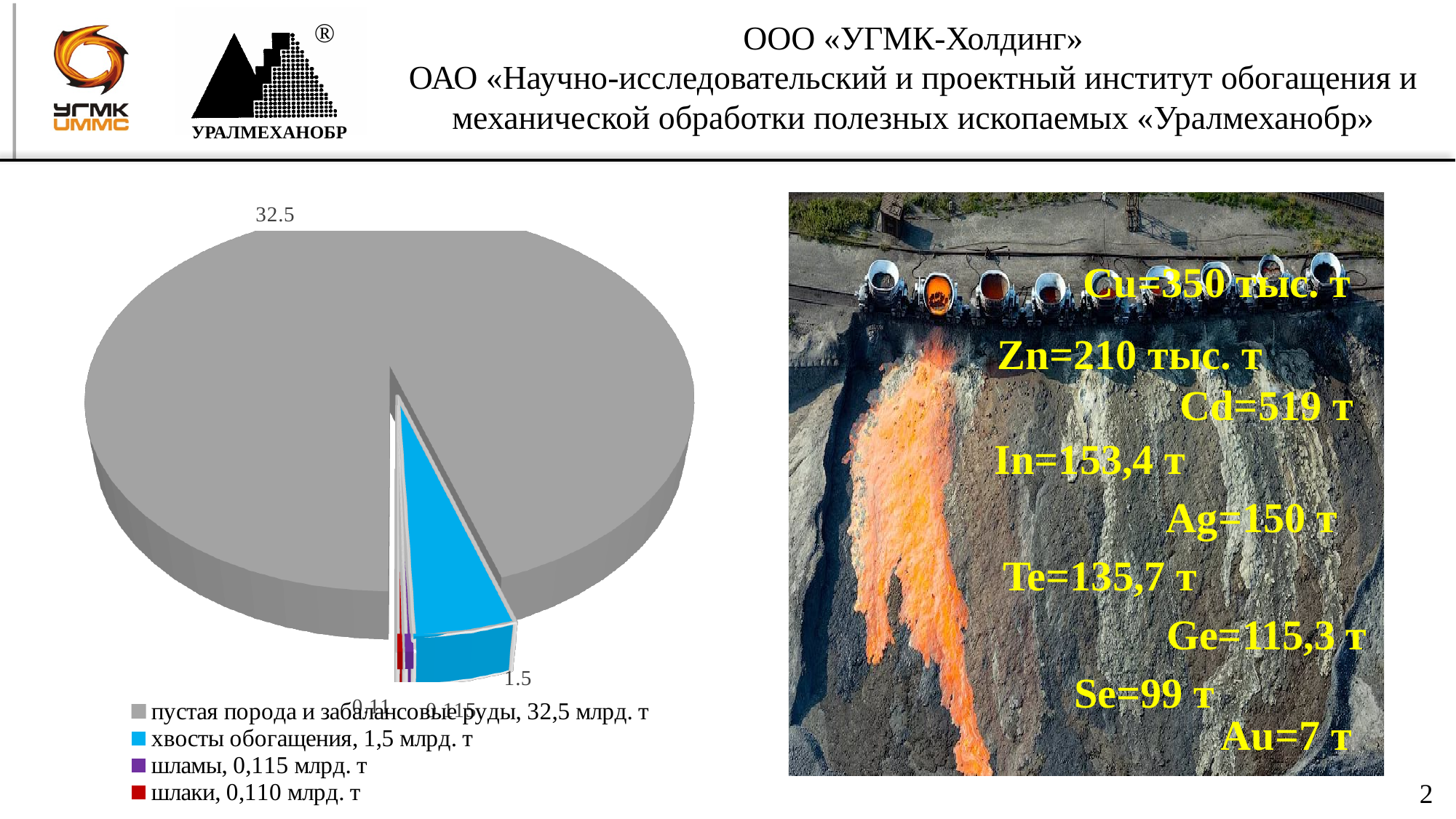
How many slices does the pie chart have? 4 What value is labelled on the blue slice (хвосты обогащения) of the pie chart? 1.5 What colour is the slice for хвосты обогащения in the pie chart? blue How many entries does the legend of the pie chart list? 4 According to the legend, what is the amount for шламы? 0,115 млрд. т What is the difference between the values for пустая порода и забалансовые руды and хвосты обогащения in the pie chart? 31 Which category has the largest slice in the pie chart? пустая порода и забалансовые руды What value is labelled on the largest (grey) slice of the pie chart? 32.5 According to the legend, what is the amount for шлаки? 0,110 млрд. т Which is larger in the pie chart: хвосты обогащения or шламы? хвосты обогащения What kind of chart is shown on the left of the slide? pie chart Which category has the smallest value in the pie chart? шлаки